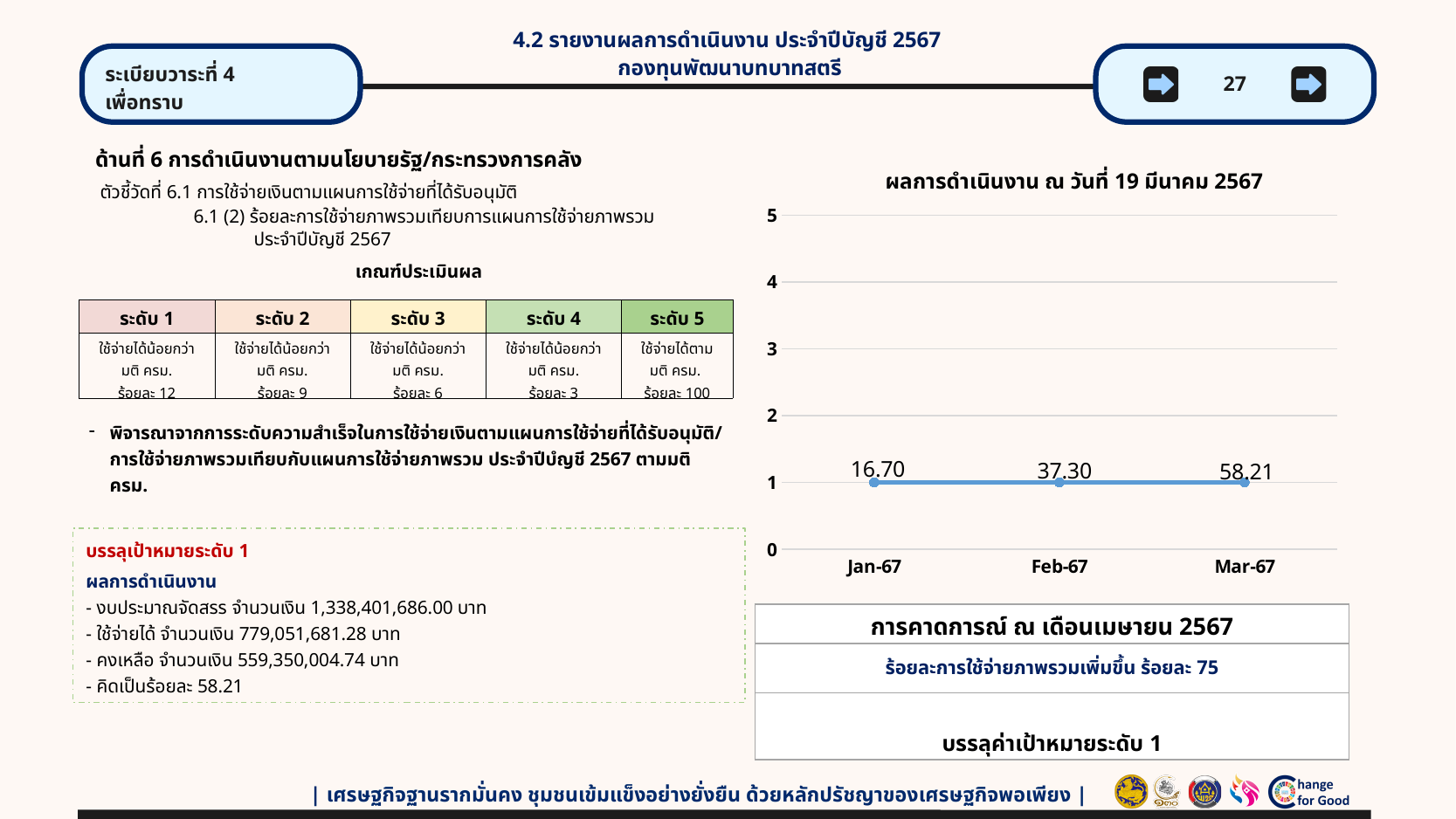
Which month has the highest data label in the chart? Mar-67 What is the title of the chart? ผลการดำเนินงาน ณ วันที่ 19 มีนาคม 2567 What is the difference between the data labels for Feb-67 and Jan-67? 20.60 What data label is shown for Jan-67 in the chart? 16.70 Do the data labels rise or fall from Jan-67 to Mar-67? Rise What data label is shown for Mar-67 in the chart? 58.21 What data label is shown for Feb-67 in the chart? 37.30 What is the difference between the data labels for Mar-67 and Jan-67? 41.51 Which month has the lowest data label in the chart? Jan-67 What kind of chart is shown on the slide? Line chart Which has the larger data label, Feb-67 or Mar-67? Mar-67 How many months are shown on the x axis of the chart? 3